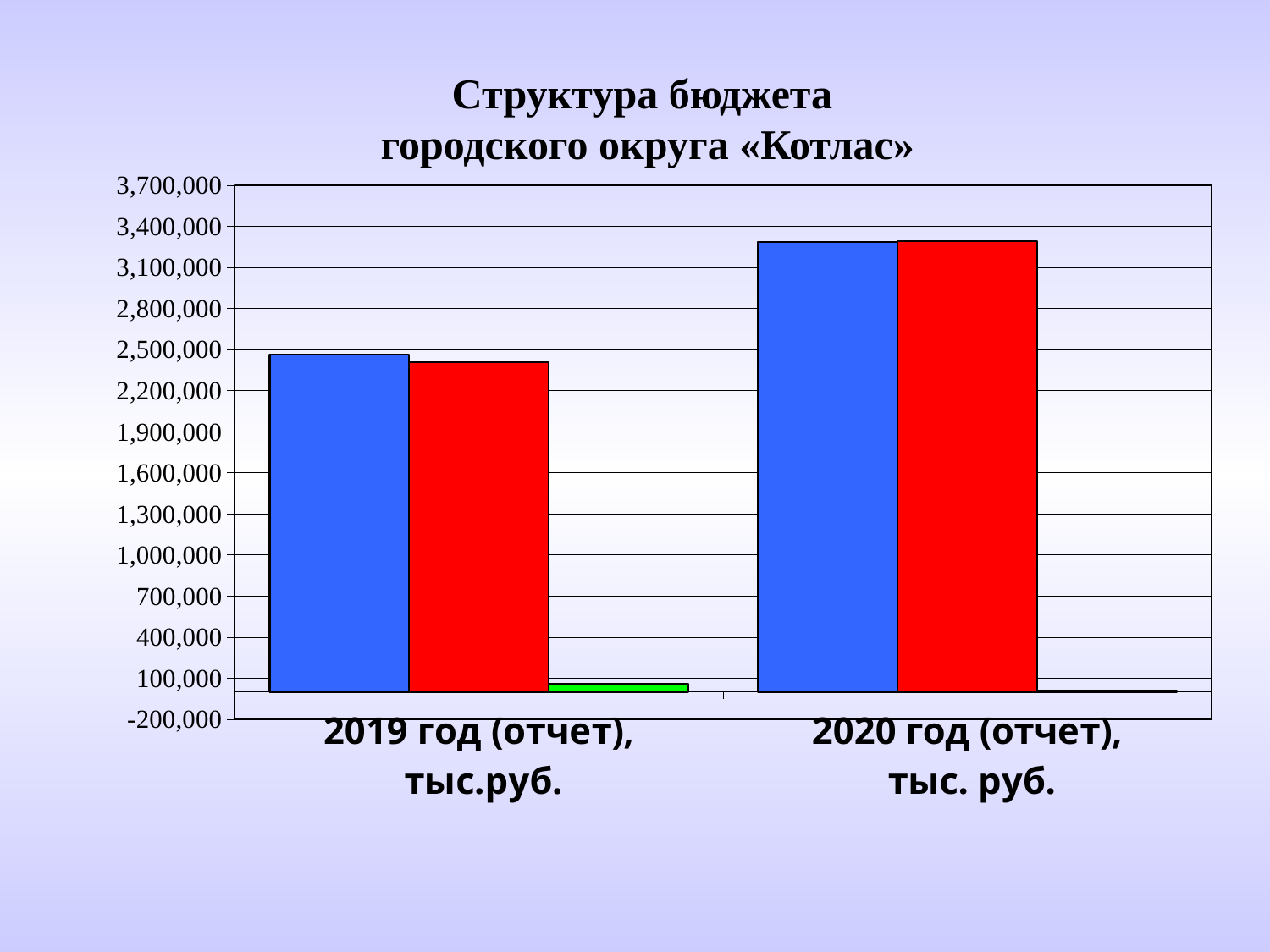
How many bars are plotted for the category "2019 год (отчет), тыс.руб."? 3 Is the value of the blue bar for "2020 год (отчет), тыс. руб." greater or less than 3,100,000? greater What kind of chart is shown on the slide? bar chart Which is larger: the blue bar for 2019 or the blue bar for 2020? the blue bar for 2020 What is the title of the chart? Структура бюджета городского округа «Котлас» Is the value of the red bar for "2020 год (отчет), тыс. руб." greater or less than 3,400,000? less How many categories are shown on the x axis? 2 Do the blue and red bars rise or fall from 2019 to 2020? rise Which is larger: the red bar for 2019 or the red bar for 2020? the red bar for 2020 Is the value of the green bar for "2019 год (отчет), тыс.руб." greater or less than 400,000? less